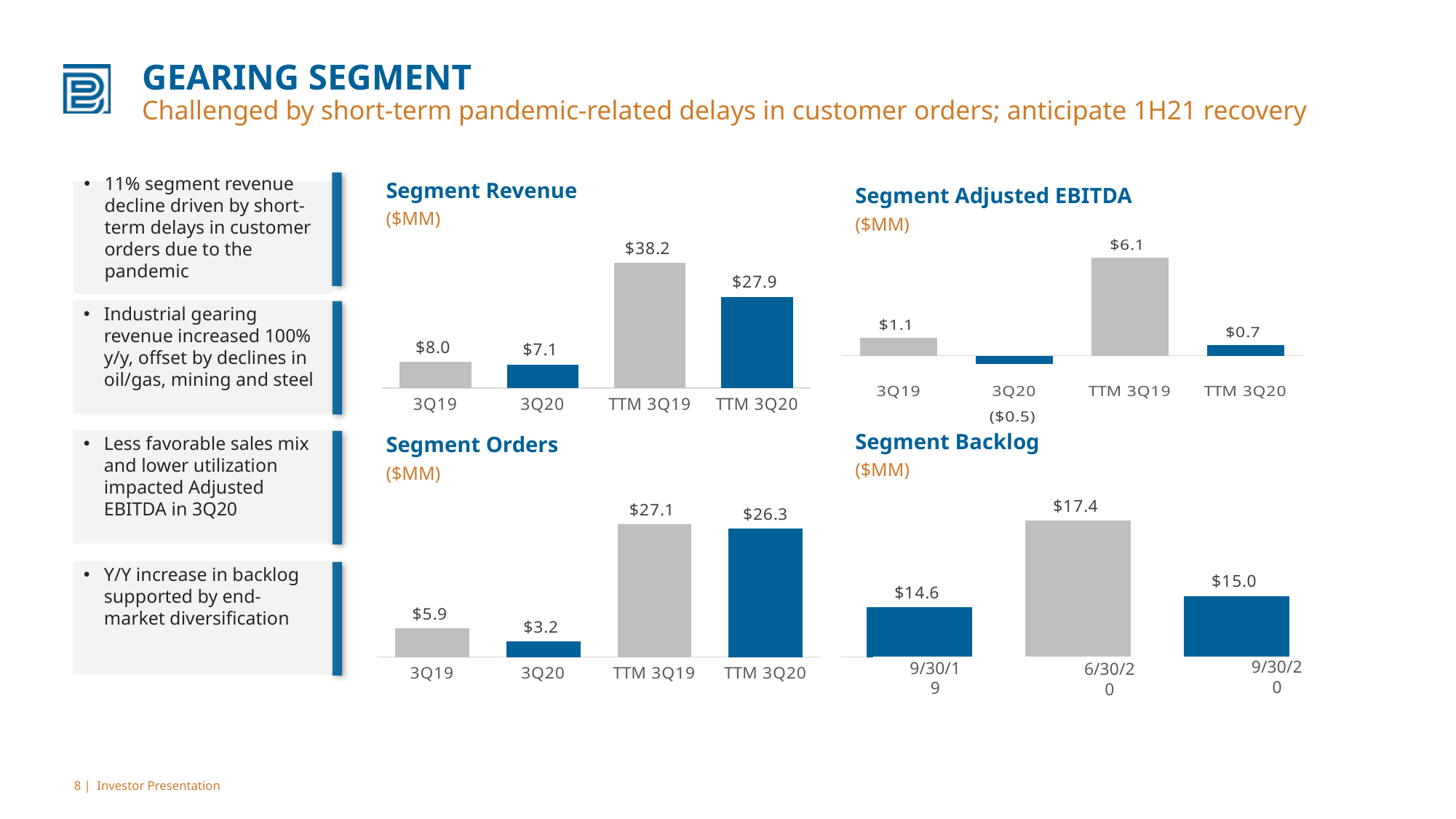
What type of chart is the Segment Orders chart? Bar chart In the Segment Adjusted EBITDA chart, which category has the highest value? TTM 3Q19 In the Segment Revenue chart, what is the difference between 3Q19 and 3Q20? $0.9 In the Segment Revenue chart, what is the value for 3Q20? $7.1 In the Segment Adjusted EBITDA chart, what is the value for 3Q20? ($0.5) In the Segment Revenue chart, what is the value for TTM 3Q19? $38.2 What unit is shown under the Segment Adjusted EBITDA chart title? ($MM) In the Segment Orders chart, what is the difference between TTM 3Q19 and TTM 3Q20? $0.8 In the Segment Orders chart, which category has the lowest value? 3Q20 How many categories are shown in the Segment Backlog chart? 3 In the Segment Backlog chart, which is larger, 9/30/19 or 9/30/20? 9/30/20 In the Segment Backlog chart, what is the value for 6/30/20? $17.4